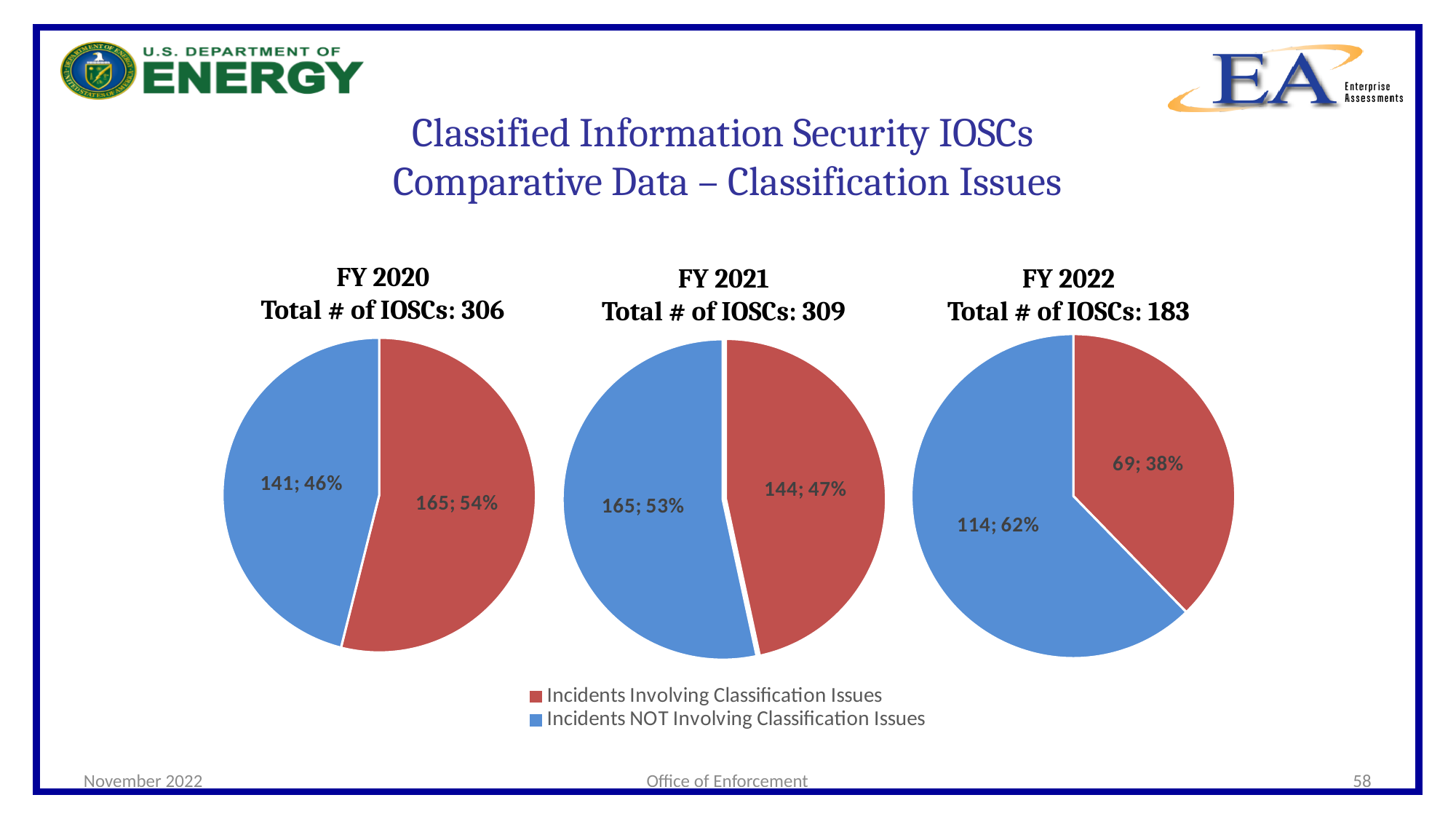
In the FY 2022 pie chart, what share of IOSCs involved classification issues? 38% In the FY 2020 pie chart, how many incidents involved classification issues? 165 In the FY 2021 pie chart, what share of IOSCs did NOT involve classification issues? 53% In the FY 2020 pie chart, what is the difference between incidents involving and not involving classification issues? 24 What kind of charts are shown on the slide? Pie charts Which fiscal year's pie chart has the lowest total number of IOSCs? FY 2022 In the FY 2022 pie chart, how many incidents involved classification issues? 69 How many entries does the legend list? 2 What colour represents incidents NOT involving classification issues? Blue In the FY 2022 pie chart, which slice is larger: incidents involving classification issues or incidents NOT involving classification issues? Incidents NOT Involving Classification Issues What is the total number of IOSCs shown for FY 2021? 309 How many pie charts are on the slide? 3